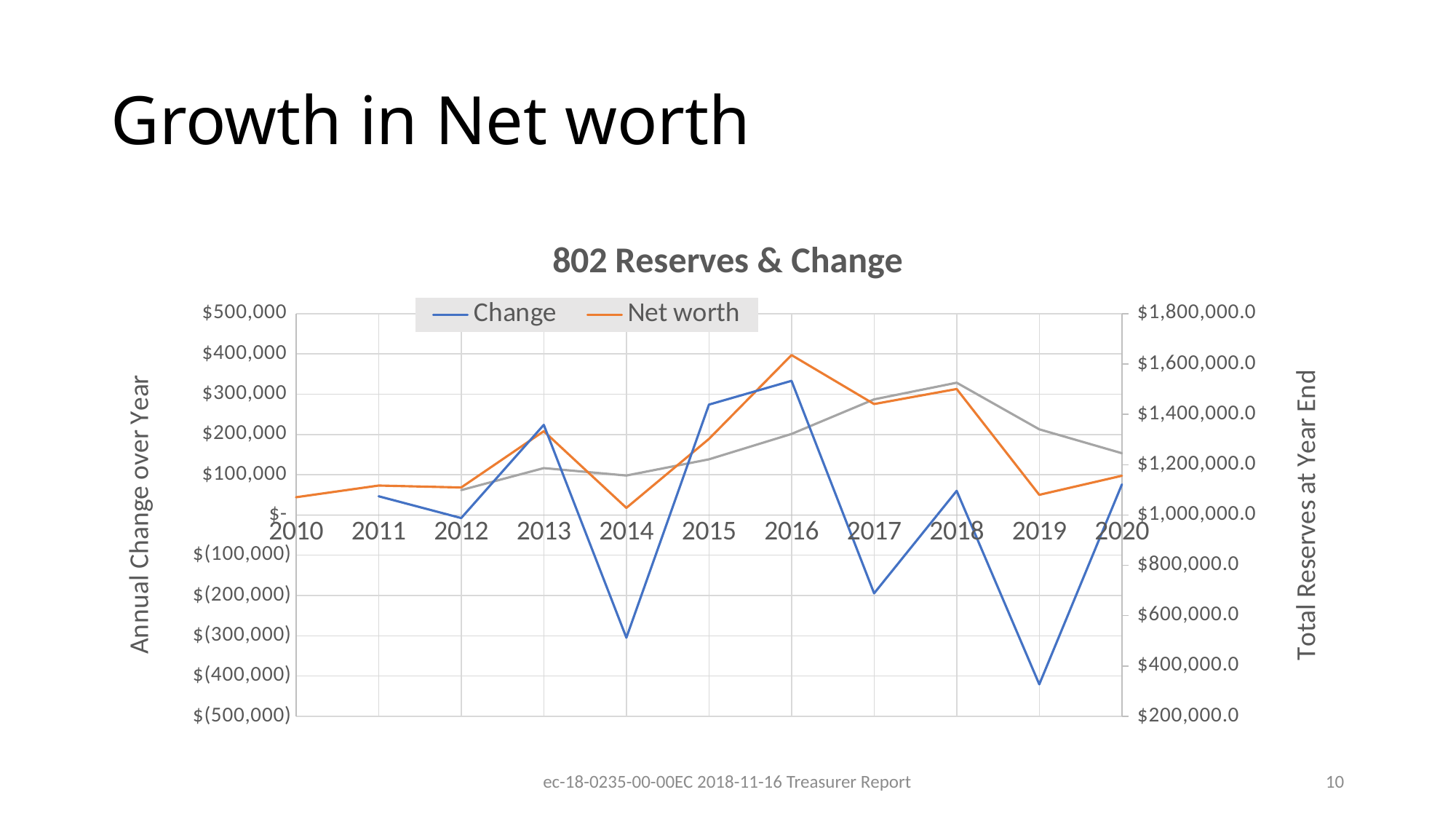
What kind of chart is shown on the slide? Line chart What is the title of the chart? 802 Reserves & Change In which year is the Net worth series at its highest? 2016 In which year is the Change series at its lowest? 2019 How many series does the chart legend list? 2 Is the Change value for 2017 greater or less than $(100,000)? less What is the title of the left vertical axis? Annual Change over Year In which year is the Change series at its highest? 2016 Is the Net worth value for 2016 greater or less than $1,400,000.0? greater Is the Change value for 2016 greater or less than $300,000? greater How many years are plotted along the x axis? 11 Which year has the larger Change value, 2013 or 2014? 2013